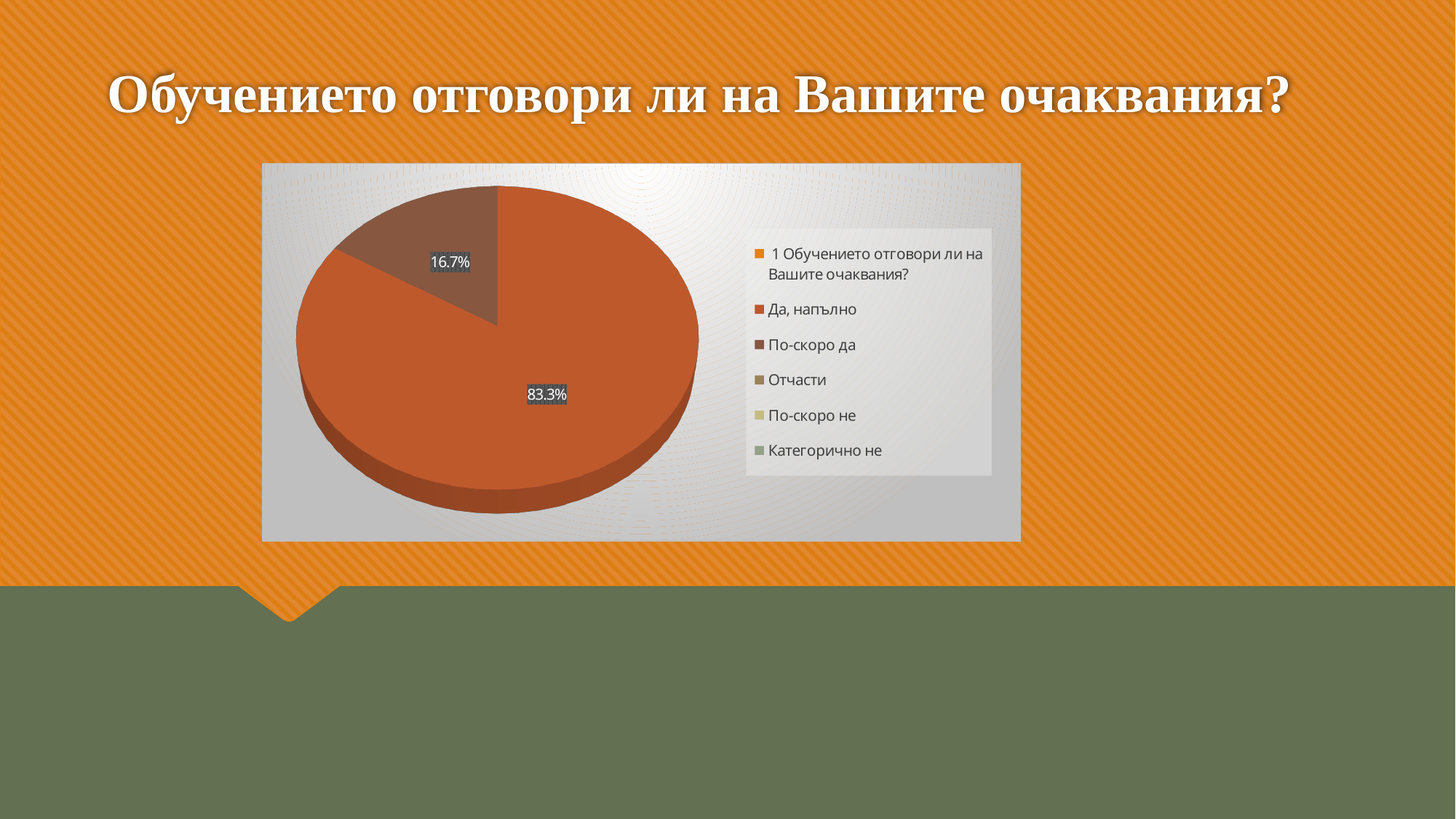
How many entries does the legend list? 6 What percentage of the pie is labelled for the slice "Да, напълно"? 83.3% Which legend entry is listed last? Категорично не Which legend category has the largest slice of the pie? Да, напълно What percentage of the pie is labelled for the slice "По-скоро да"? 16.7% What kind of chart is shown on the slide? pie chart What share of the pie does the "По-скоро да" slice take? 16.7% How many slices with data labels are visible in the pie? 2 Which slice is larger, "Да, напълно" or "По-скоро да"? Да, напълно What is the title of the slide? Обучението отговори ли на Вашите очаквания? Which of the two labelled slices is the smaller one? По-скоро да What is the difference in percentage points between the "Да, напълно" slice and the "По-скоро да" slice? 66.6